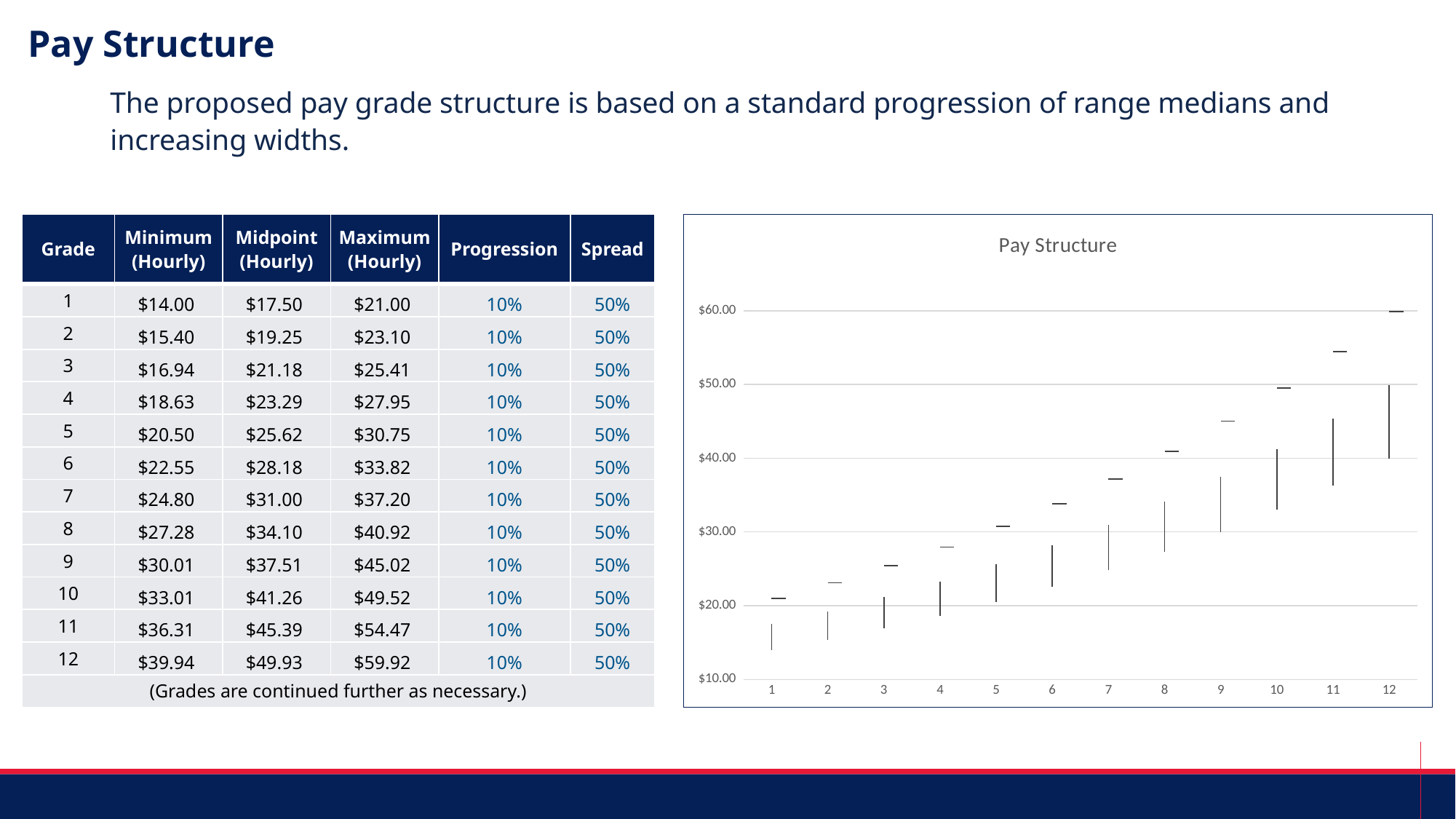
In the Pay Structure chart, is the top marker for grade 1 greater or less than $30.00? less In the Pay Structure chart, is the top marker for grade 9 greater or less than $40.00? greater In the Pay Structure chart, do the plotted values rise or fall as the grade number increases from 1 to 12? rise What are the lowest and highest tick labels on the y axis of the Pay Structure chart? $10.00 and $60.00 How many grades are plotted along the x axis of the Pay Structure chart? 12 In the Pay Structure chart, which grade has the highest plotted values? 12 What is the title of the chart on the right side of the slide? Pay Structure In the Pay Structure chart, which grade has higher plotted values, grade 4 or grade 10? 10 In the Pay Structure chart, which grade has the lowest plotted values? 1 In the Pay Structure chart, is the top marker for grade 3 greater or less than $30.00? less